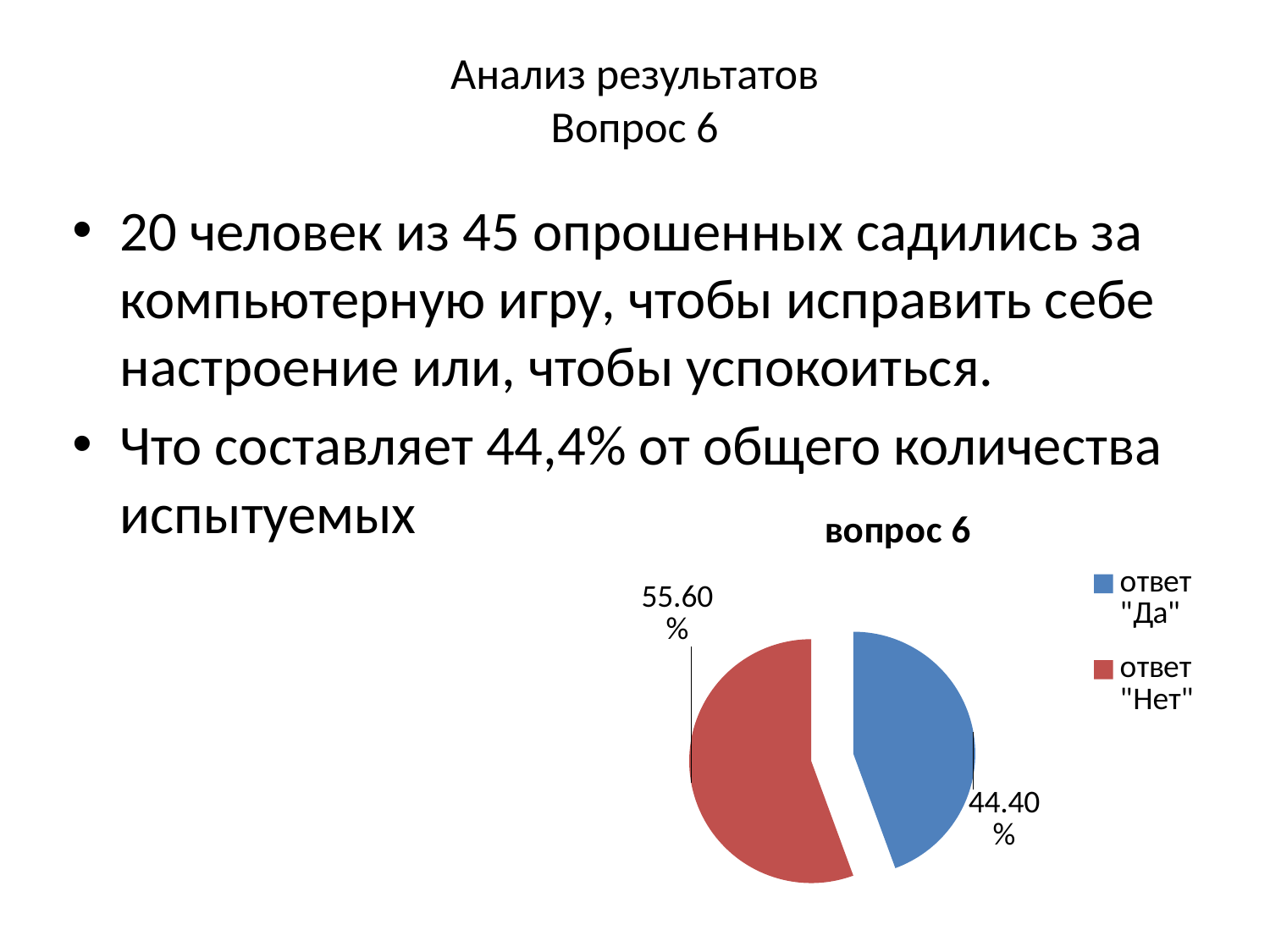
What colour is the slice for ответ "Да"? blue Which is larger: the share for ответ "Да" or the share for ответ "Нет"? ответ "Нет" How many slices does the pie chart have? 2 Is the share for ответ "Нет" greater or less than 50%? greater What share of the pie is labelled ответ "Нет"? 55.60% What is the title of the chart? вопрос 6 Which slice of the pie is the smallest? ответ "Да" What is the difference between the ответ "Нет" share and the ответ "Да" share? 11.20% What type of chart is shown on the slide? pie chart Which slice of the pie is the largest? ответ "Нет" How many entries does the legend list? 2 What share of the pie is labelled ответ "Да"? 44.40%